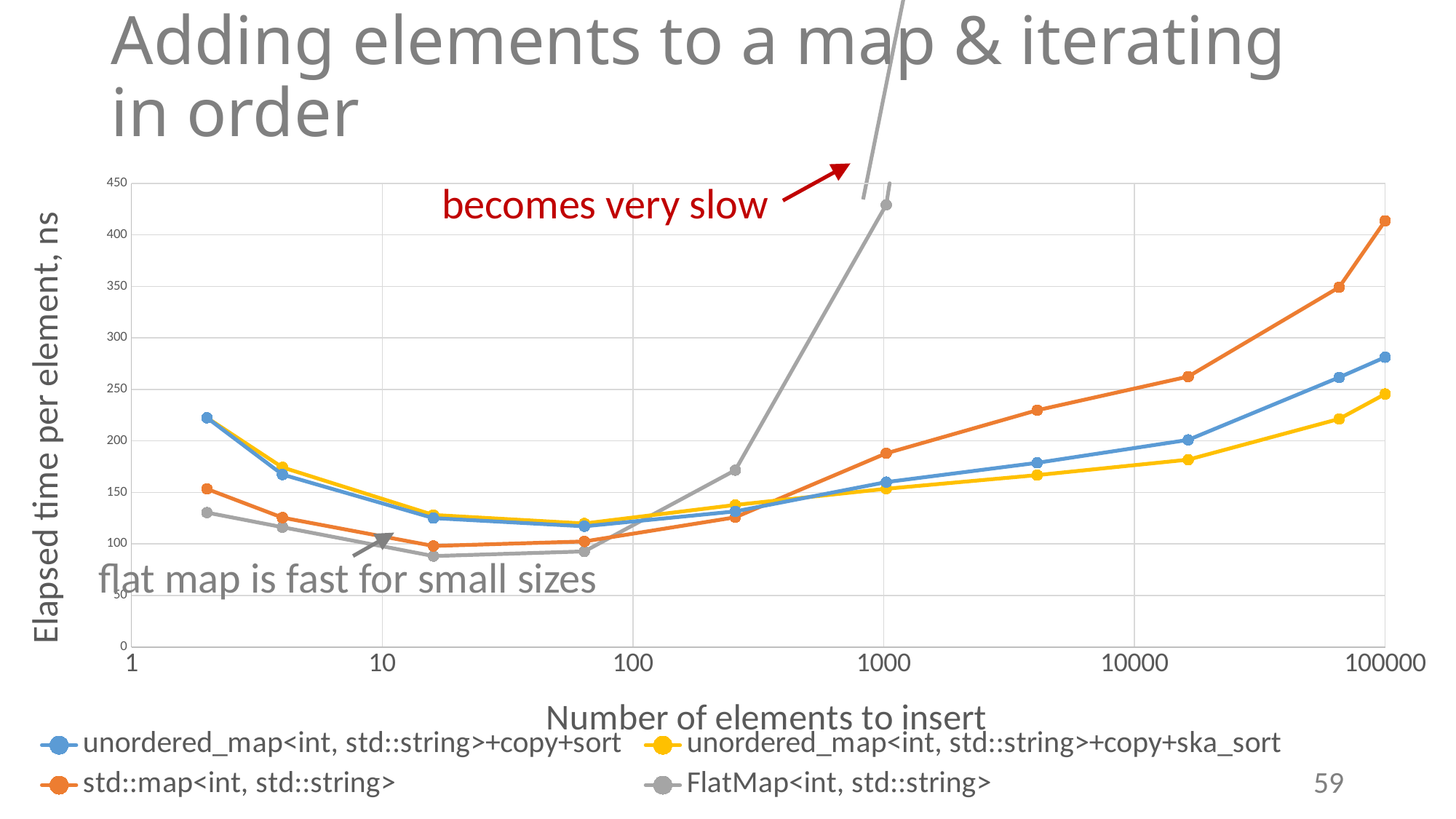
How many series does the legend list? 4 Which series is drawn in grey? FlatMap<int, std::string> What kind of chart is shown on the slide? line chart Is the value for FlatMap<int, std::string> at 1000 elements greater or less than 400? greater Does the std::map<int, std::string> series rise or fall as the number of elements increases from 100 to 100000? rise Is the value for std::map<int, std::string> at 100000 elements greater or less than 400? greater Is the value for FlatMap<int, std::string> at about 16 elements greater or less than 100? less At 2 elements, which is larger: FlatMap<int, std::string> or unordered_map<int, std::string>+copy+sort? unordered_map<int, std::string>+copy+sort What is the label of the y axis? Elapsed time per element, ns At 100000 elements, which is larger: std::map<int, std::string> or unordered_map<int, std::string>+copy+ska_sort? std::map<int, std::string>